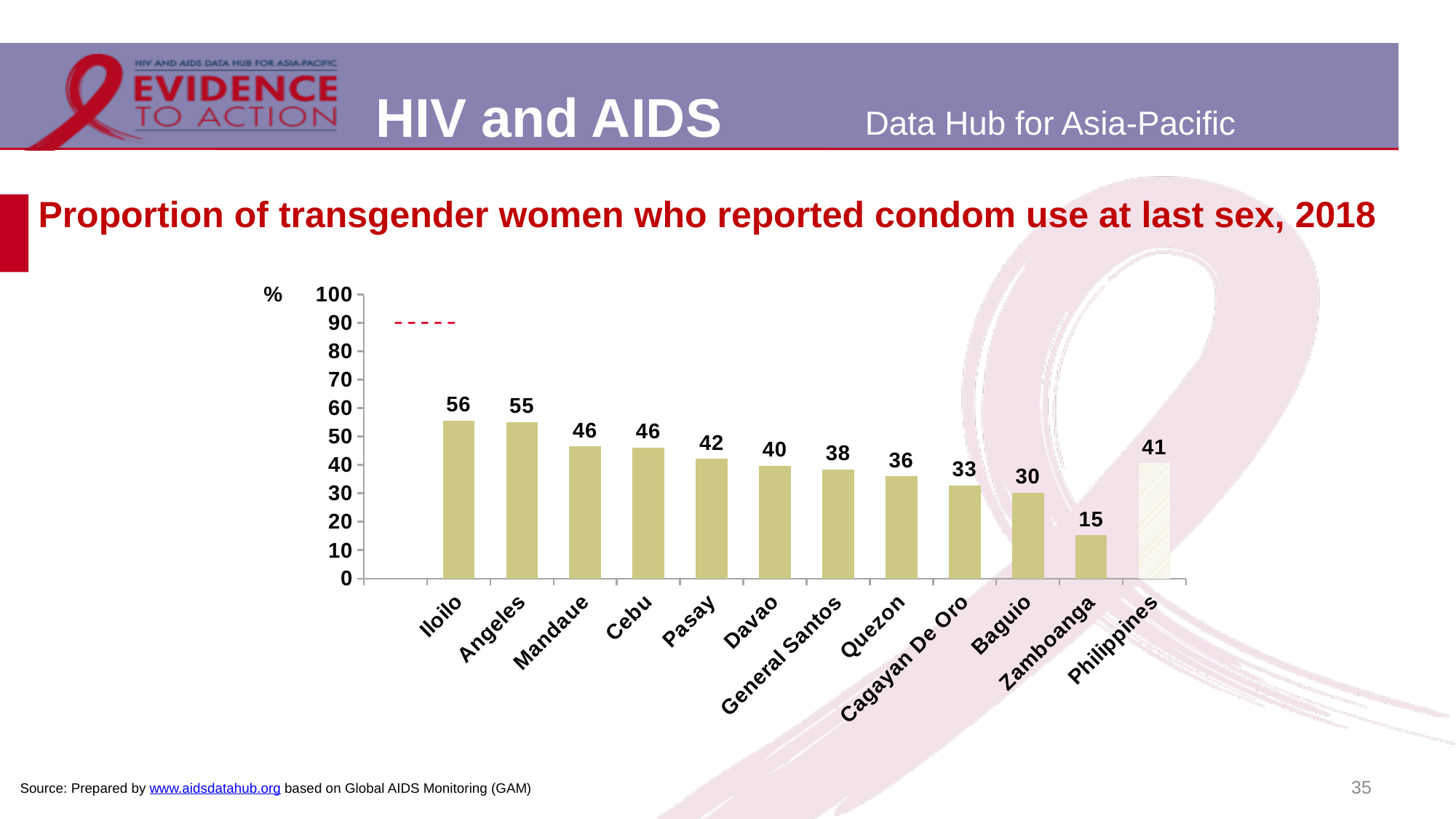
What is the value for Iloilo? 56 What is the value for Zamboanga? 15 Which category has the highest value? Iloilo What is the value for Philippines? 41 What kind of chart is shown on the slide? Bar chart What is the title of the chart? Proportion of transgender women who reported condom use at last sex, 2018 Which is larger, the value for Pasay or the value for Davao? Pasay Which category has the lowest value? Zamboanga Do the values for the cities from Iloilo to Zamboanga rise or fall along the x axis? Fall What is the difference between the values for Iloilo and Zamboanga? 41 How many categories are shown on the x axis? 12 What is the value for General Santos? 38